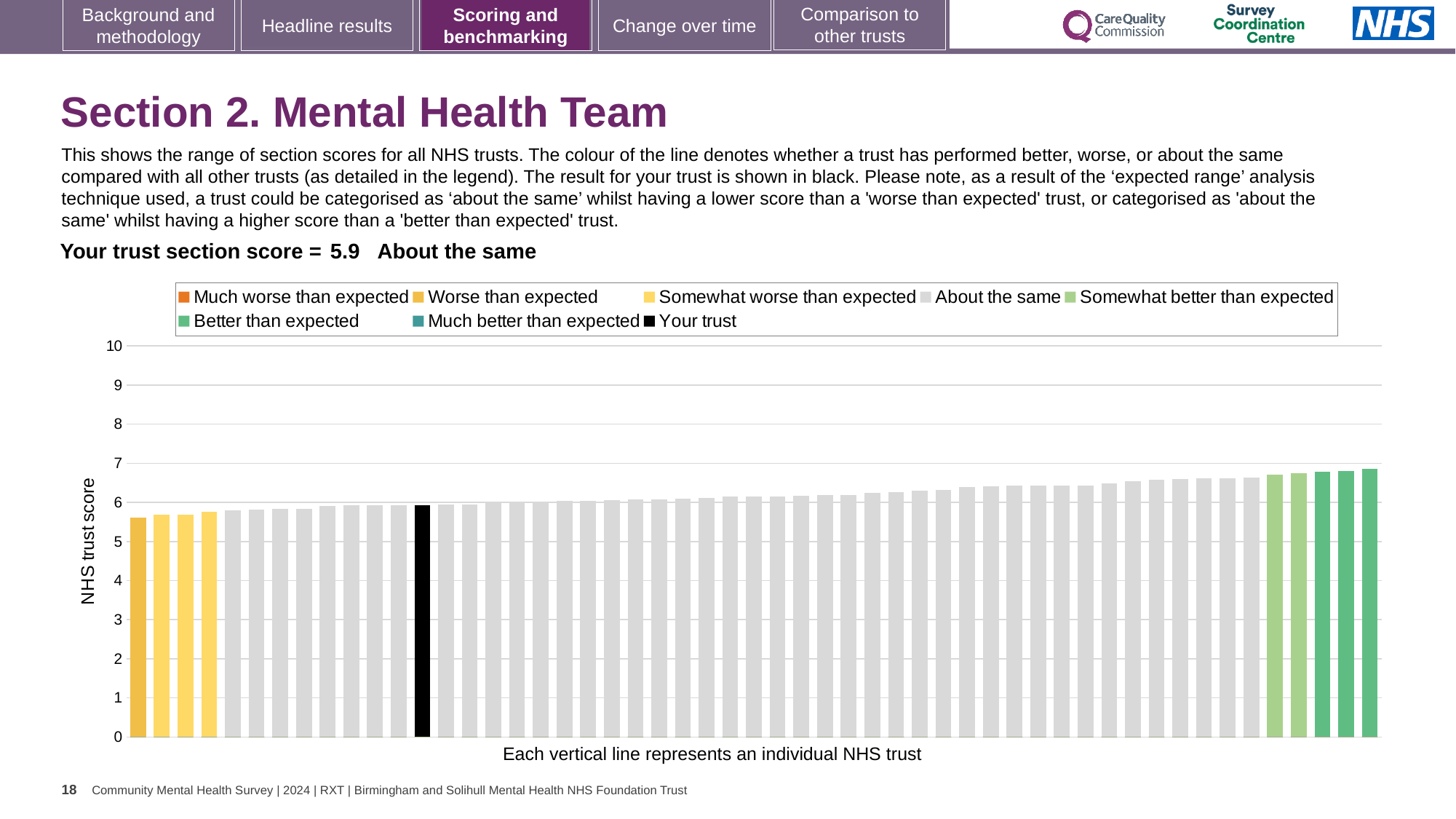
What colour is the bar representing your trust? black What is the label on the vertical axis of the chart? NHS trust score How many entries does the chart legend list? 8 What category is your trust placed in for this section? About the same Is the value of the lowest bar greater or less than 6? less Is the value of the highest bar greater or less than 6? greater What kind of chart is shown on the slide? bar chart Which is larger, the leftmost bar or the rightmost bar? the rightmost bar What is the section score for your trust shown on the slide? 5.9 Is the value for your trust (the black bar) greater or less than 7? less Do the bar values rise or fall from left to right along the x axis? rise